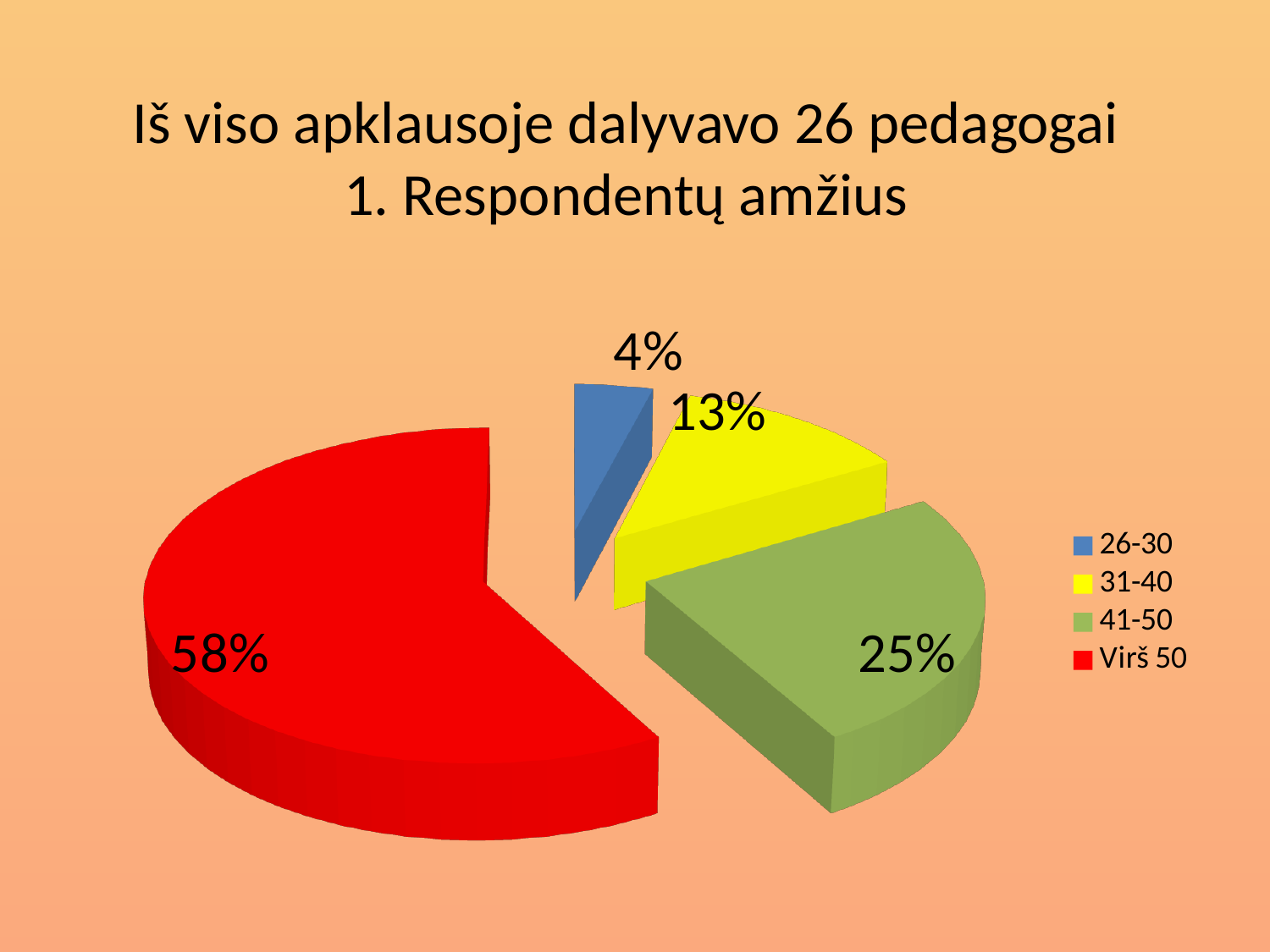
What is the difference in percentage points between the Virš 50 and 41-50 slices? 33 How many pedagogues participated in the survey according to the slide title? 26 What kind of chart is shown on the slide? pie chart Which slice is larger, 31-40 or 41-50? 41-50 What share of respondents are in the 41-50 age group? 25% Which age group has the largest share of respondents? Virš 50 What share of respondents are in the Virš 50 age group? 58% How many age groups does the pie chart show? 4 What share of respondents are in the 31-40 age group? 13% Which age group has the smallest share of respondents? 26-30 What colour is the slice for the 31-40 age group? yellow